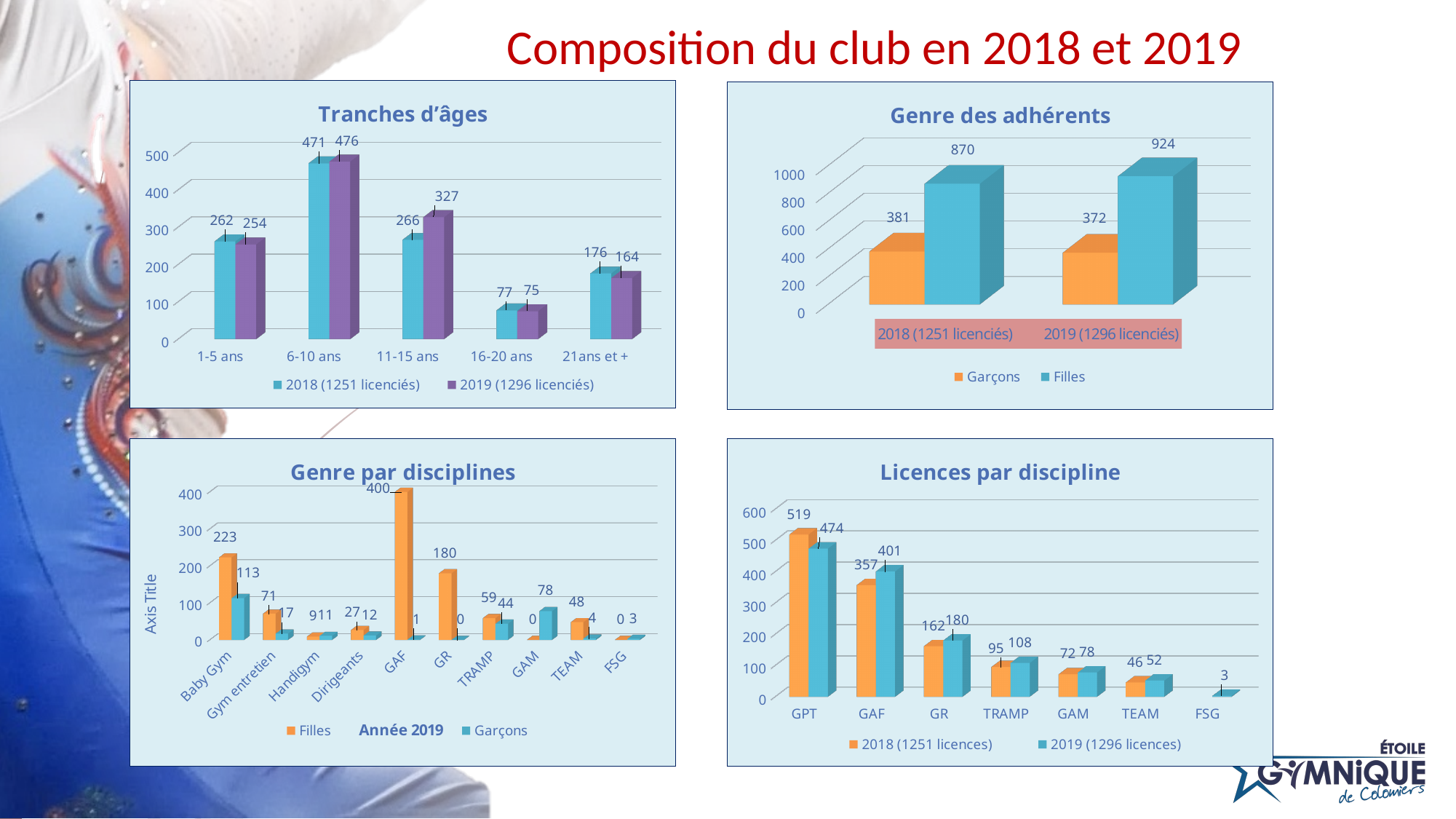
In the 'Tranches d'âges' chart, what is the difference between the 2019 and 2018 values for 11-15 ans? 61 In the 'Genre par disciplines' chart, what is the value for Filles in GAF? 400 In the 'Genre des adhérents' chart, what is the difference between Filles and Garçons in 2018 (1251 licenciés)? 489 In the 'Genre par disciplines' chart, which discipline has the highest value for Garçons? Baby Gym In the 'Genre par disciplines' chart, how many disciplines are shown on the x axis? 10 In the 'Tranches d'âges' chart, which age group has the highest value for 2018 (1251 licenciés)? 6-10 ans What kind of chart is 'Licences par discipline'? Bar chart In the 'Licences par discipline' chart, what is the value for GAF in 2019 (1296 licences)? 401 In the 'Tranches d'âges' chart, what is the value for 11-15 ans in 2019 (1296 licenciés)? 327 In the 'Genre des adhérents' chart, what is the value for Filles in 2019 (1296 licenciés)? 924 In the 'Licences par discipline' chart, which is larger for GPT: 2018 (1251 licences) or 2019 (1296 licences)? 2018 (1251 licences) In the 'Genre des adhérents' chart, how many series does the legend list? 2